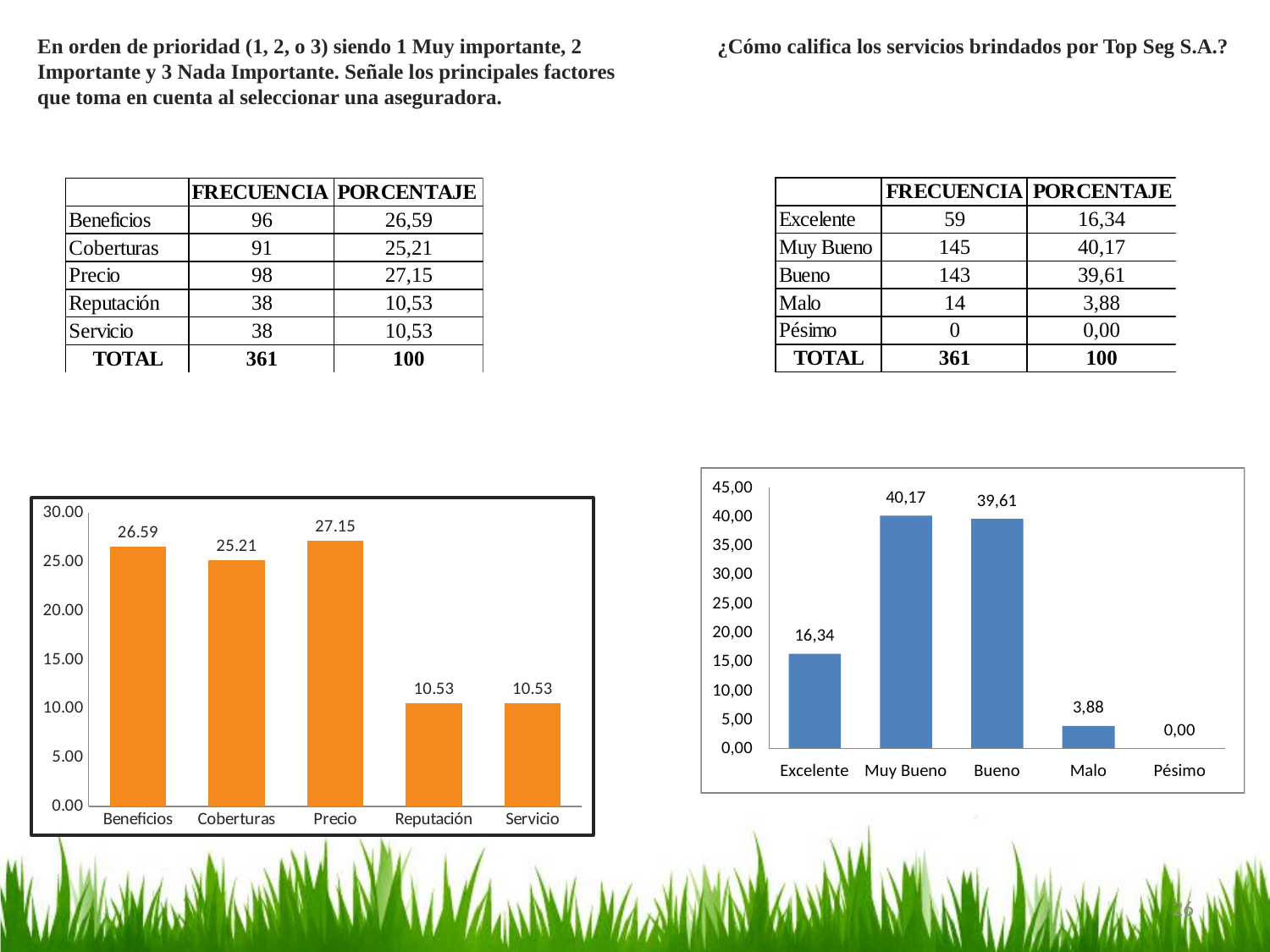
In the left chart, which category has the highest value? Precio In the left chart, what is the difference between the values for Precio and Coberturas? 1.94 How many categories are shown in the right chart? 5 In the right chart, is the value for Bueno greater or less than 35,00? greater In the left chart, what is the value for Reputación? 10.53 What kind of chart is the left chart? bar chart In the right chart, what is the value for Muy Bueno? 40,17 In the left chart, what is the value for Precio? 27.15 What colour are the bars in the right chart? blue In the left chart, which is larger, the value for Beneficios or the value for Coberturas? Beneficios In the right chart, what is the difference between the values for Excelente and Malo? 12,46 In the right chart, which category has the lowest value? Pésimo